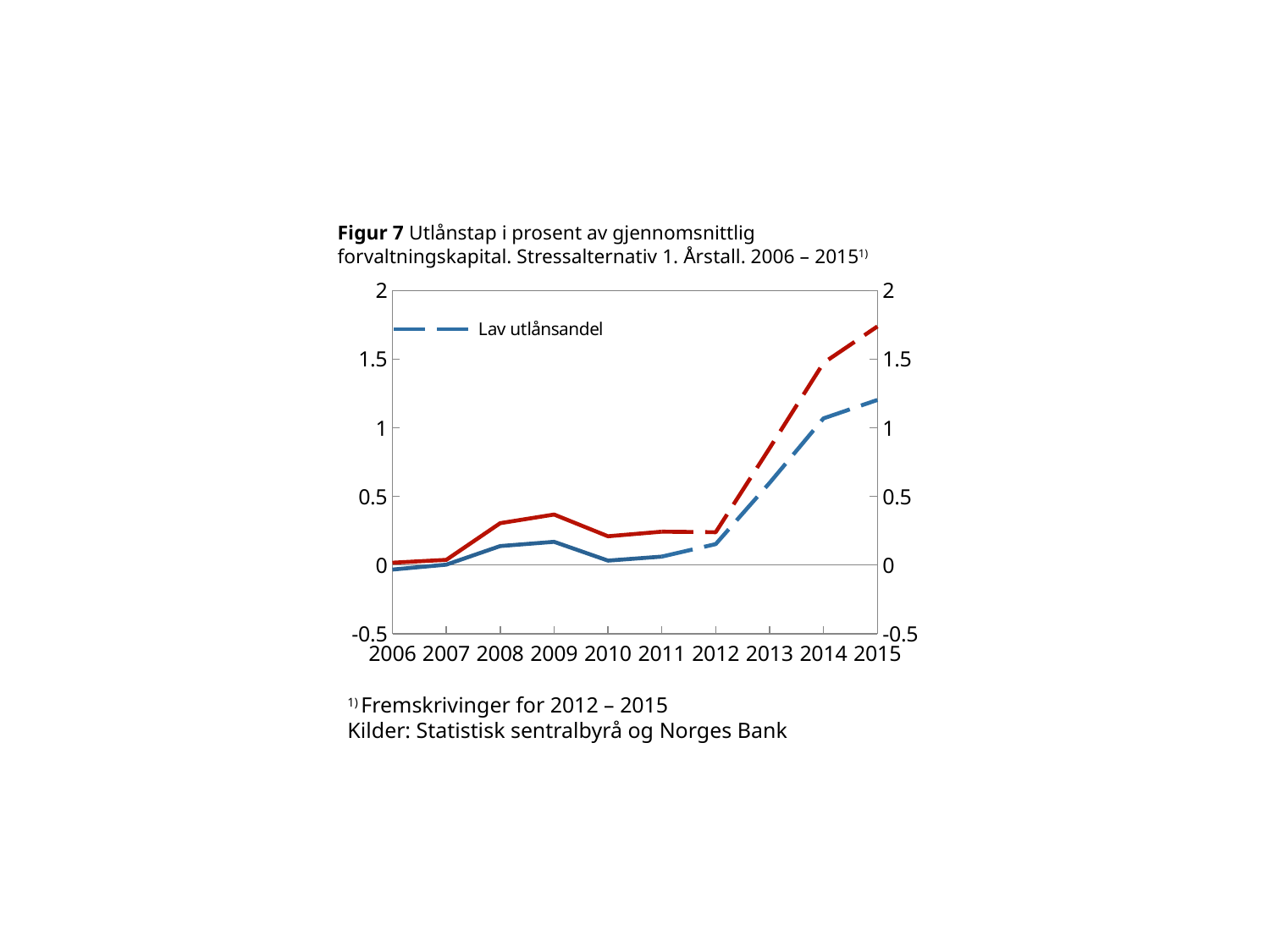
Which year has the highest value for the red series? 2015 How many years are shown on the x axis of the chart? 10 Is the value for the red series in 2009 greater or less than 0.5? less What is the series name shown in the chart's legend? Lav utlånsandel Which year has the highest value for the Lav utlånsandel (blue dashed) series? 2015 Do the values of both series rise or fall from 2012 to 2015? rise What kind of chart is shown on the slide? line chart Is the value for the red series in 2015 greater or less than 1.5? greater Is the value for Lav utlånsandel in 2013 greater or less than 0.5? greater In 2015, which series has the larger value, the red series or Lav utlånsandel? the red series How many series does the chart's legend list? 1